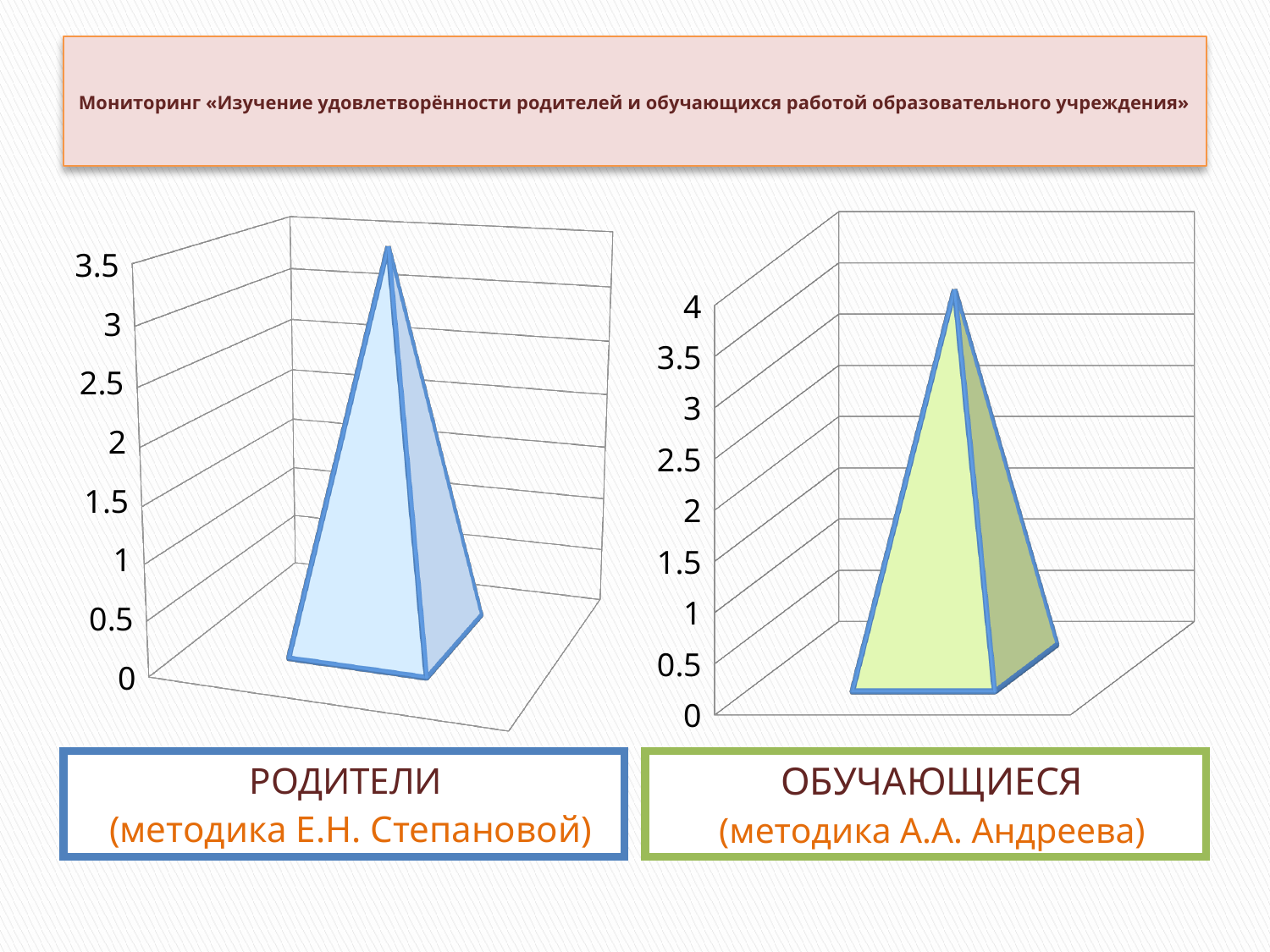
How many bars are plotted in the left chart (РОДИТЕЛИ)? 1 In the right chart (ОБУЧАЮЩИЕСЯ), is the value of the bar greater or less than 2.5? greater What kind of chart is the left chart (РОДИТЕЛИ)? bar chart In the left chart (РОДИТЕЛИ), is the value of the bar greater or less than 3? greater Which methodology is named under the right chart (ОБУЧАЮЩИЕСЯ)? методика А.А. Андреева What kind of chart is the right chart (ОБУЧАЮЩИЕСЯ)? bar chart In the left chart (РОДИТЕЛИ), is the value of the bar greater or less than 2? greater What is the highest value shown on the vertical axis of the right chart (ОБУЧАЮЩИЕСЯ)? 4 How many bars are plotted in the right chart (ОБУЧАЮЩИЕСЯ)? 1 What is the highest value shown on the vertical axis of the left chart (РОДИТЕЛИ)? 3.5